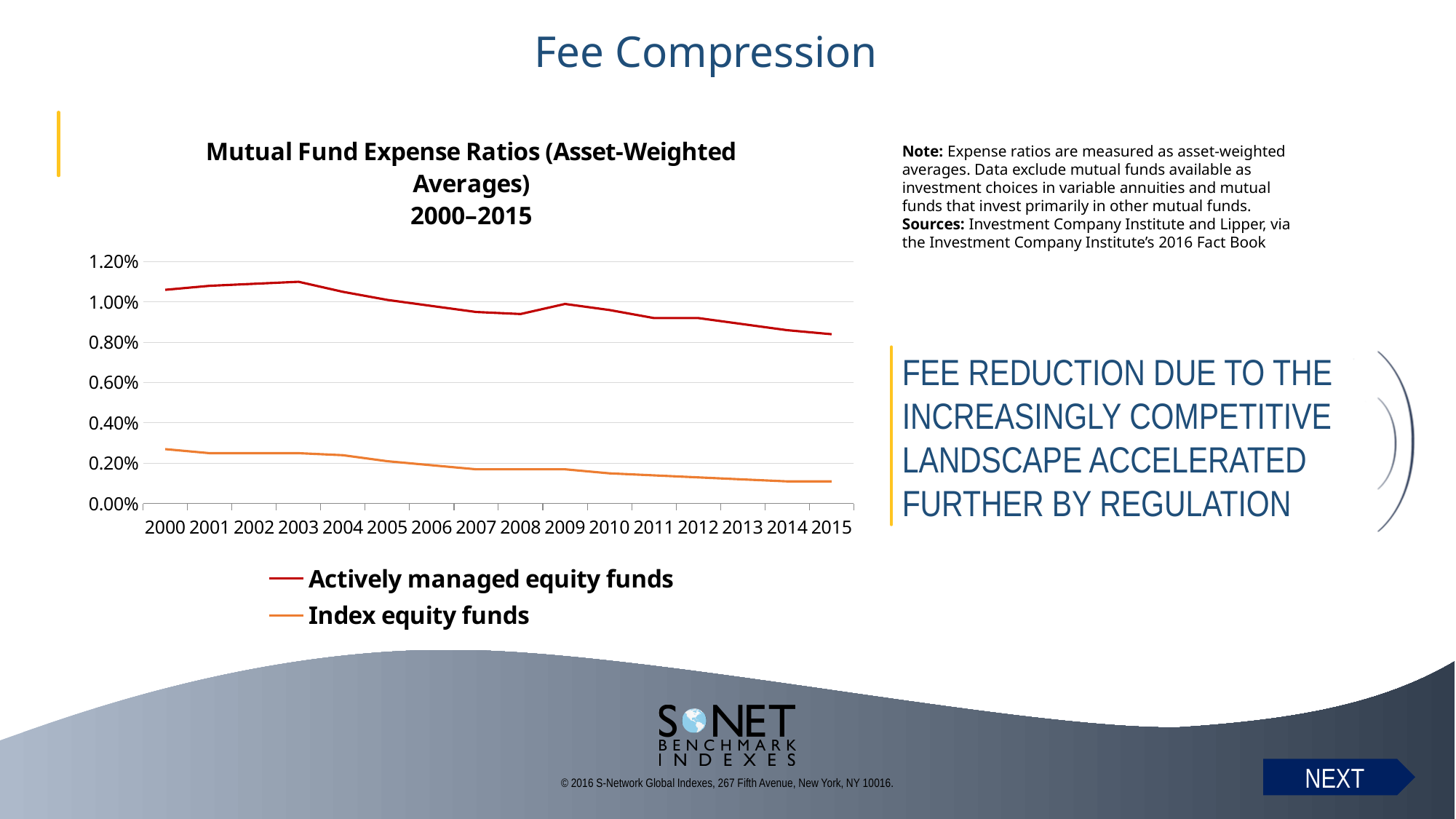
In which year is the expense ratio for actively managed equity funds lowest? 2015 How many series does the legend list? 2 Is the 2015 value for index equity funds greater or less than 0.20%? less Which series has the higher expense ratio in 2010, actively managed equity funds or index equity funds? Actively managed equity funds What kind of chart is shown on the slide? Line chart Is the 2003 value for actively managed equity funds greater or less than 1.00%? greater In which year is the expense ratio for actively managed equity funds highest? 2003 How many years are plotted along the x axis? 16 Is the 2015 value for actively managed equity funds greater or less than 1.00%? less Does the expense ratio for actively managed equity funds rise or fall overall from 2000 to 2015? Fall In which year is the expense ratio for index equity funds highest? 2000 Does the expense ratio for index equity funds rise or fall overall from 2000 to 2015? Fall